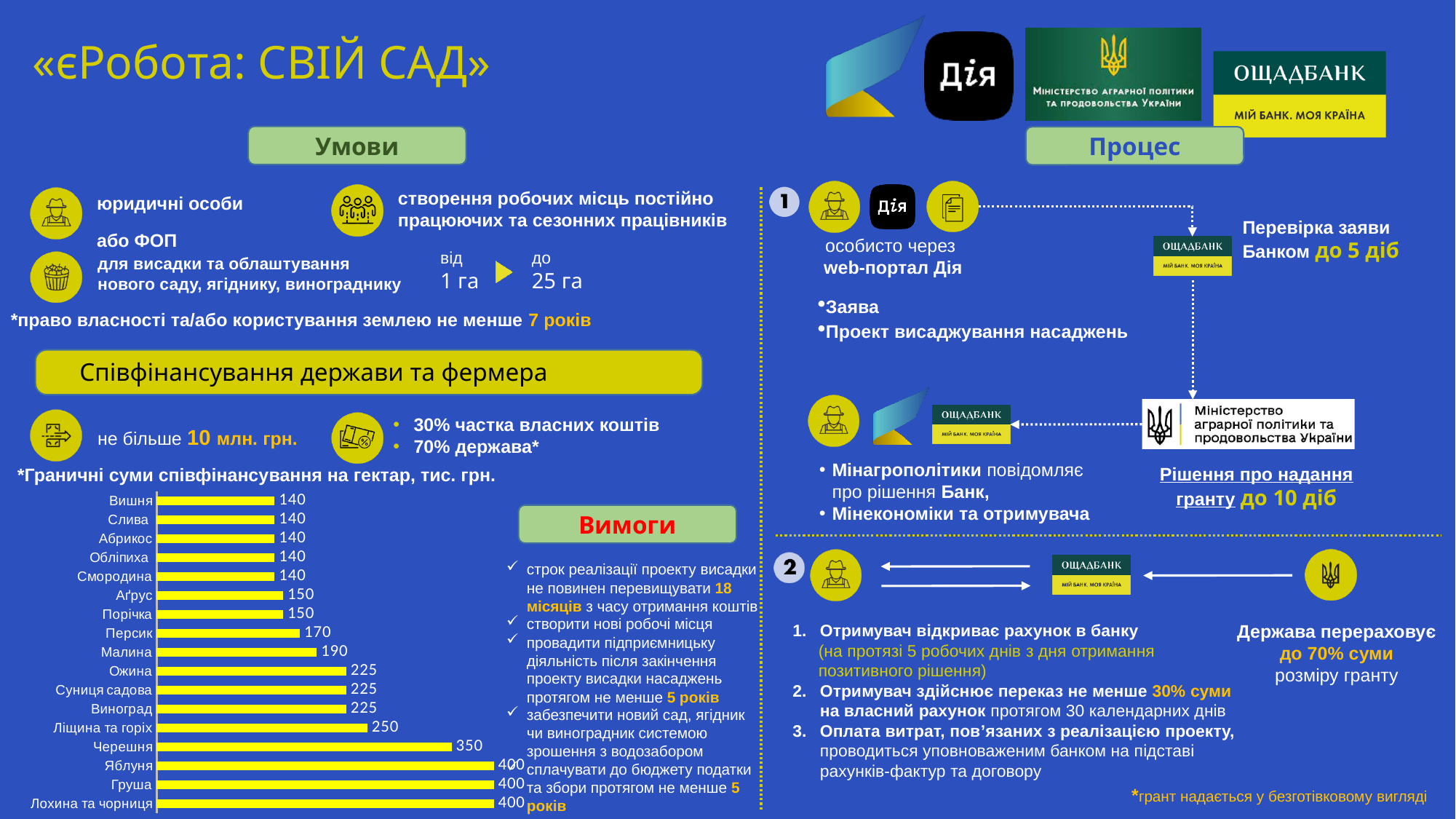
What type of chart is shown on the slide? Bar chart What is the value for Малина in the bar chart? 190 What is the difference between the values for Ожина and Вишня in the bar chart? 85 What is the title of the bar chart? *Граничні суми співфінансування на гектар, тис. грн. How many categories are shown in the bar chart? 17 What is the difference between the values for Яблуня and Черешня in the bar chart? 50 Which categories have the highest value in the bar chart? Яблуня, Груша, Лохина та чорниця What is the value for Персик in the bar chart? 170 What is the value for Ліщина та горіх in the bar chart? 250 What is the lowest value shown in the bar chart? 140 What is the value for Черешня in the bar chart? 350 Which is larger in the bar chart, the value for Малина or the value for Аґрус? Малина